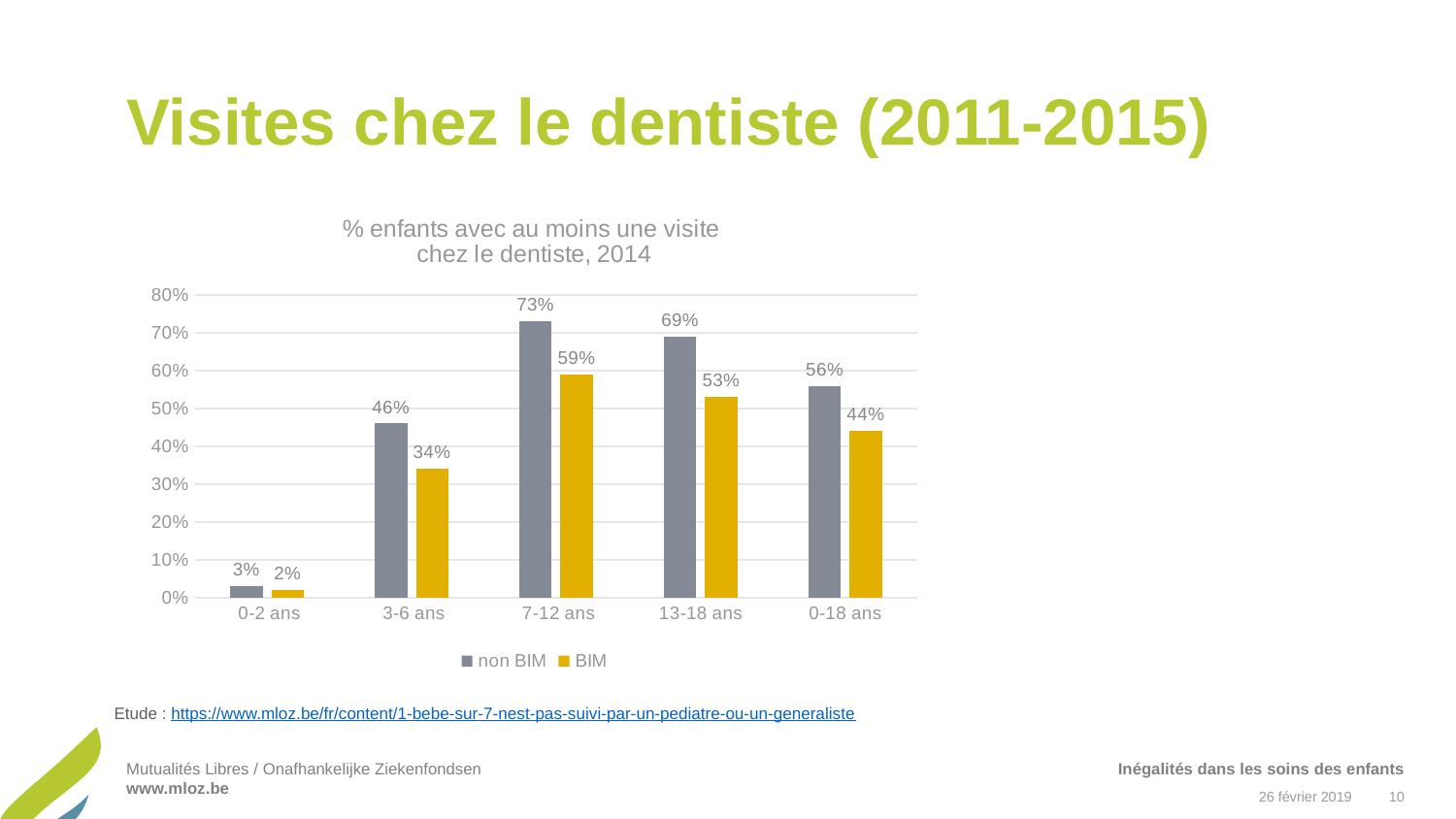
What is the title of the chart? % enfants avec au moins une visite chez le dentiste, 2014 What is the difference between the non BIM and BIM values for 13-18 ans? 16% How many series does the legend list? 2 Which age category has the highest non BIM value? 7-12 ans What is the value for BIM in the 3-6 ans category? 34% Is the BIM value for 7-12 ans greater or less than 50%? greater What kind of chart is shown on the slide? bar chart What is the value for BIM in the 0-18 ans category? 44% Which age category has the lowest BIM value? 0-2 ans Which is larger in the 3-6 ans category, non BIM or BIM? non BIM What is the value for non BIM in the 7-12 ans category? 73% How many age categories are shown on the x axis? 5